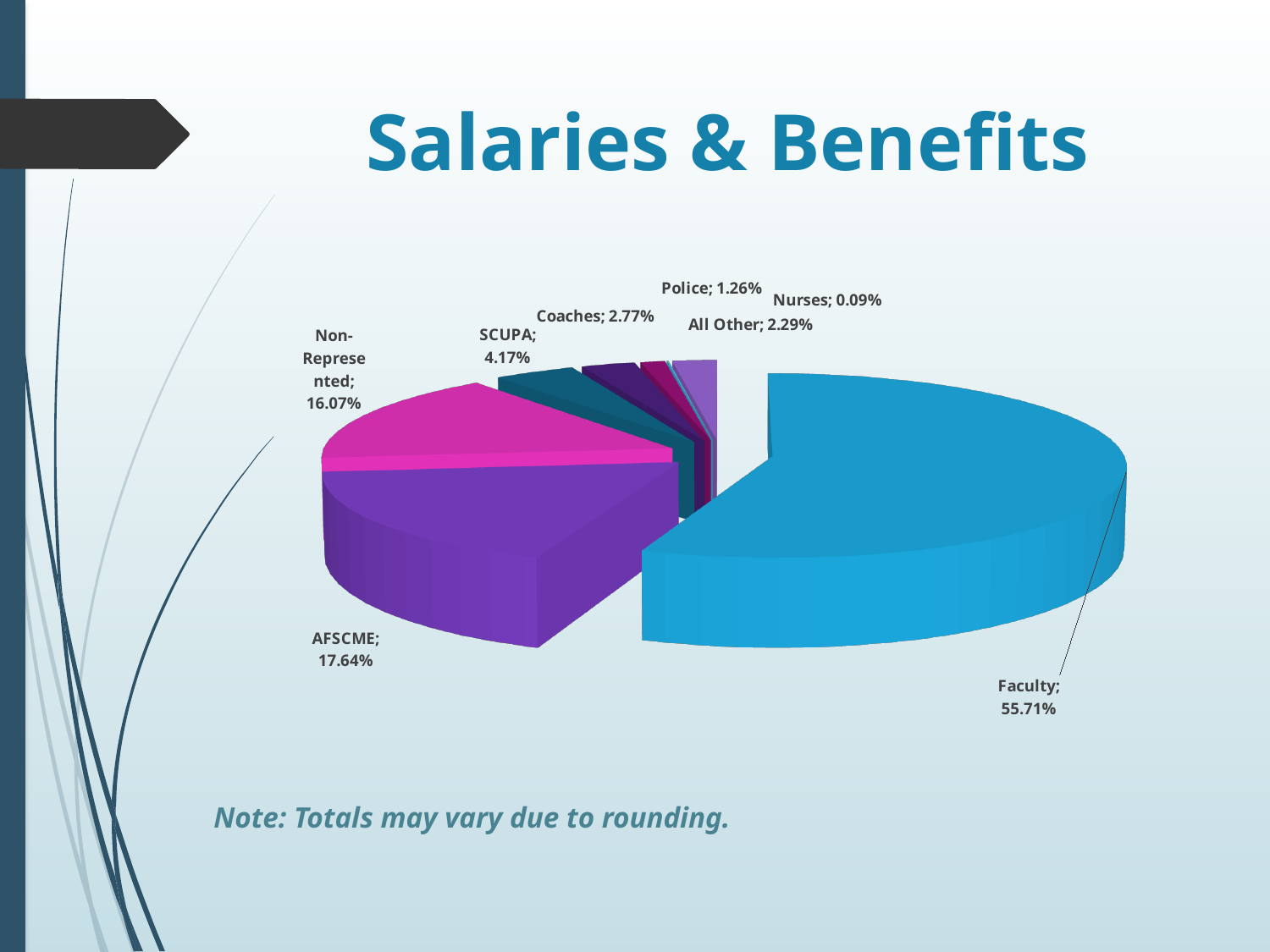
Which category has the smallest share of the pie? Nurses Which category has the largest share of the pie? Faculty What percentage is shown for Non-Represented? 16.07% What is the difference in percentage points between AFSCME and Non-Represented? 1.57 What percentage is shown for SCUPA? 4.17% What percentage is shown for AFSCME? 17.64% What type of chart is shown on the slide? Pie chart How many categories are shown in the pie chart? 8 What percentage is shown for Coaches? 2.77% Which is larger, the share for Police or the share for All Other? All Other What percentage is shown for Nurses? 0.09% What share of Salaries & Benefits goes to Faculty? 55.71%